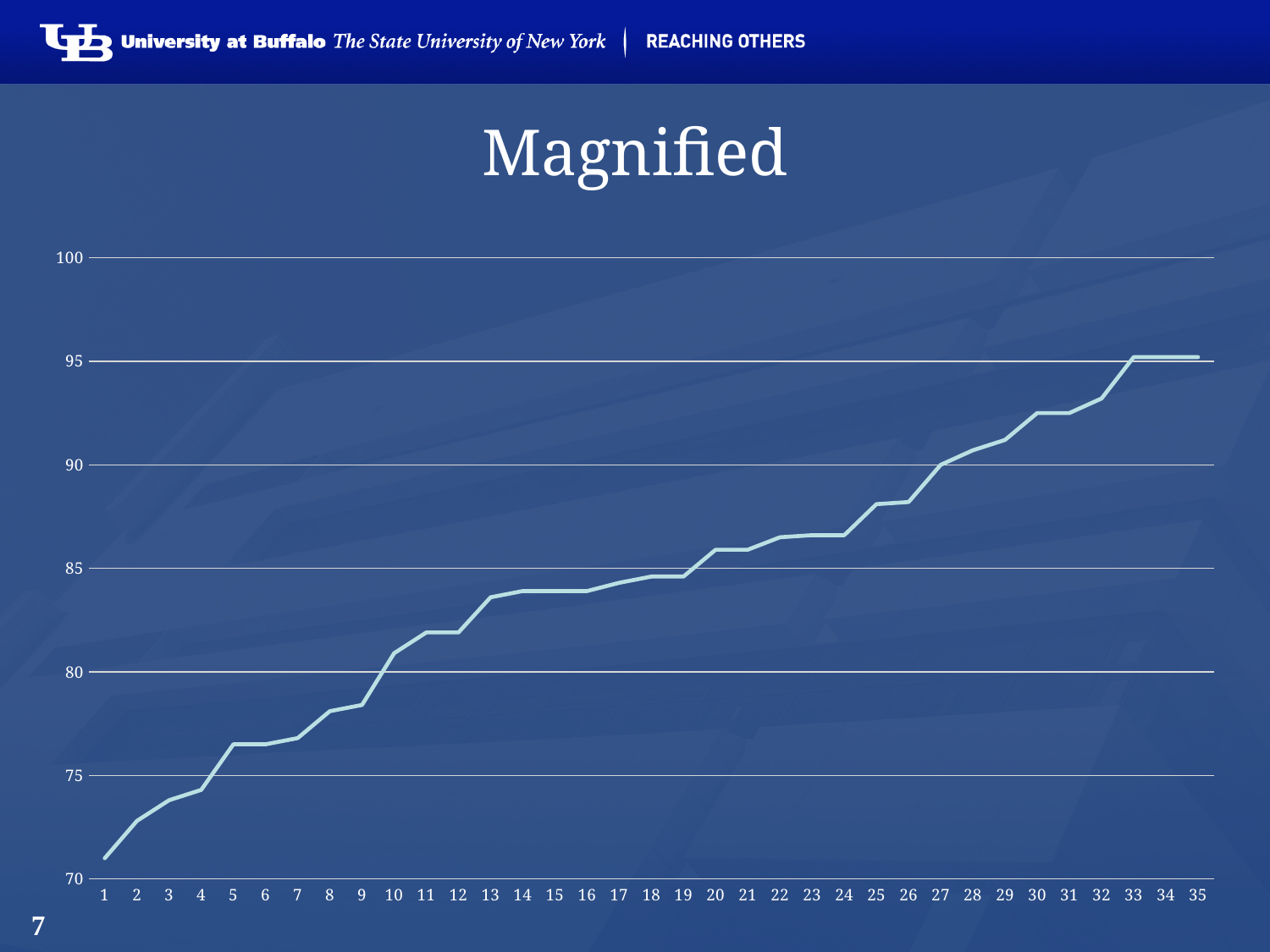
Is the value at point 15 greater or less than 85? less What is the lowest value shown on the y axis? 70 Do the values rise or fall as the x axis goes from 1 to 35? rise Which is larger, the value at point 10 or the value at point 20? point 20 Is the value at point 1 greater or less than 75? less Which x-axis point has the lowest value? 1 Is the value at point 25 greater or less than 90? less How many points are plotted along the x axis? 35 What kind of chart is shown on the slide? line chart What is the title of the chart? Magnified